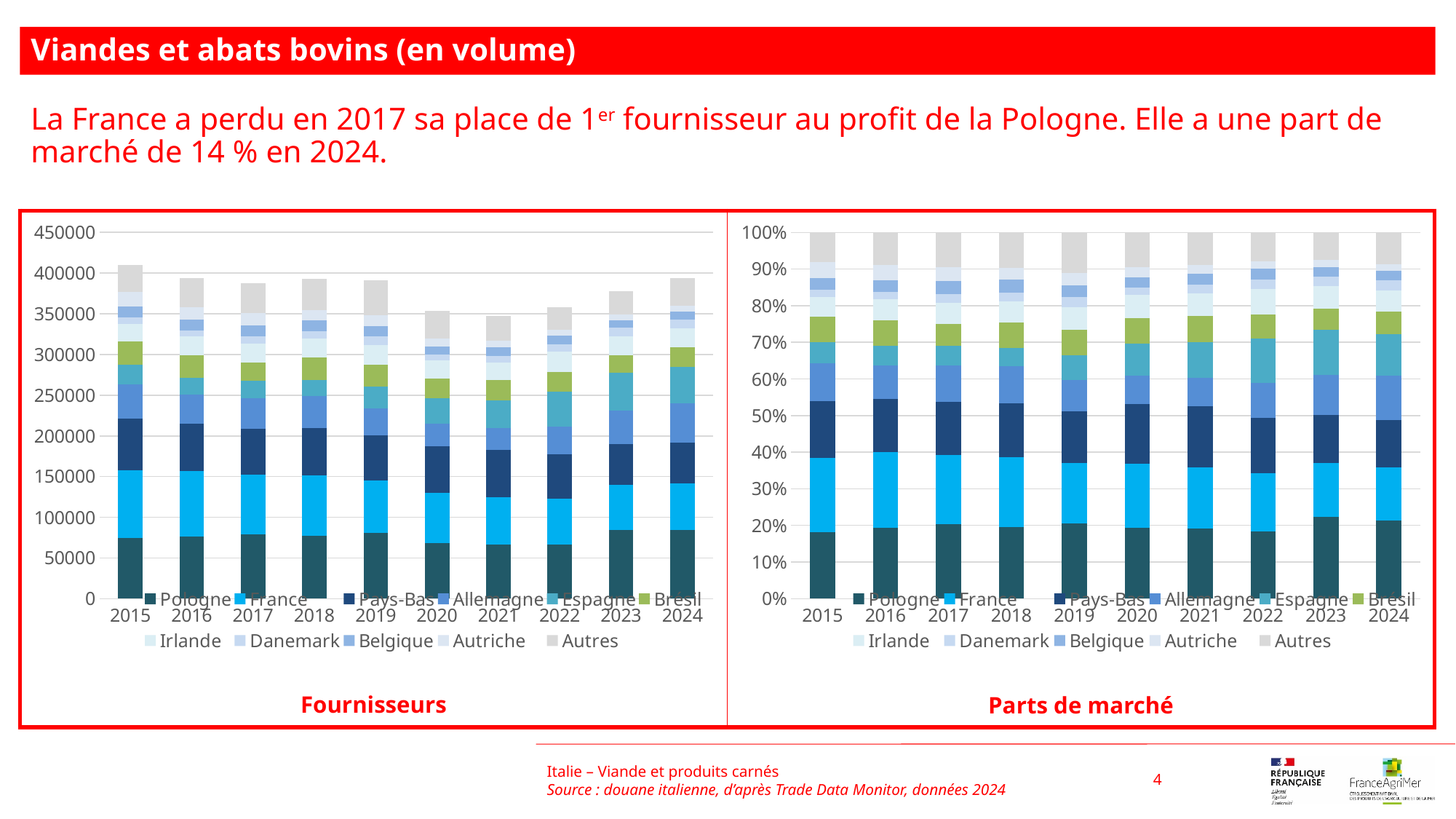
In the 'Parts de marché' chart, is the share for Pologne in 2015 greater or less than 20%? less What kind of chart is the 'Fournisseurs' chart on the left? stacked bar chart In the 'Fournisseurs' chart, which year has the highest total bar? 2015 How many series does the legend of the 'Fournisseurs' chart list? 11 In the 'Fournisseurs' chart, is the total of the 2020 bar greater or less than 400000? less Which series is listed first in the legend of the 'Fournisseurs' chart? Pologne What is the title of the chart on the right of the slide? Parts de marché In the 'Fournisseurs' chart, is the total of the 2015 bar greater or less than 400000? greater In the 'Fournisseurs' chart, does the total bar rise or fall from 2019 to 2020? fall How many years are shown on the x axis of the 'Parts de marché' chart? 10 In the 'Fournisseurs' chart, is the total bar for 2015 larger or smaller than the total bar for 2020? larger